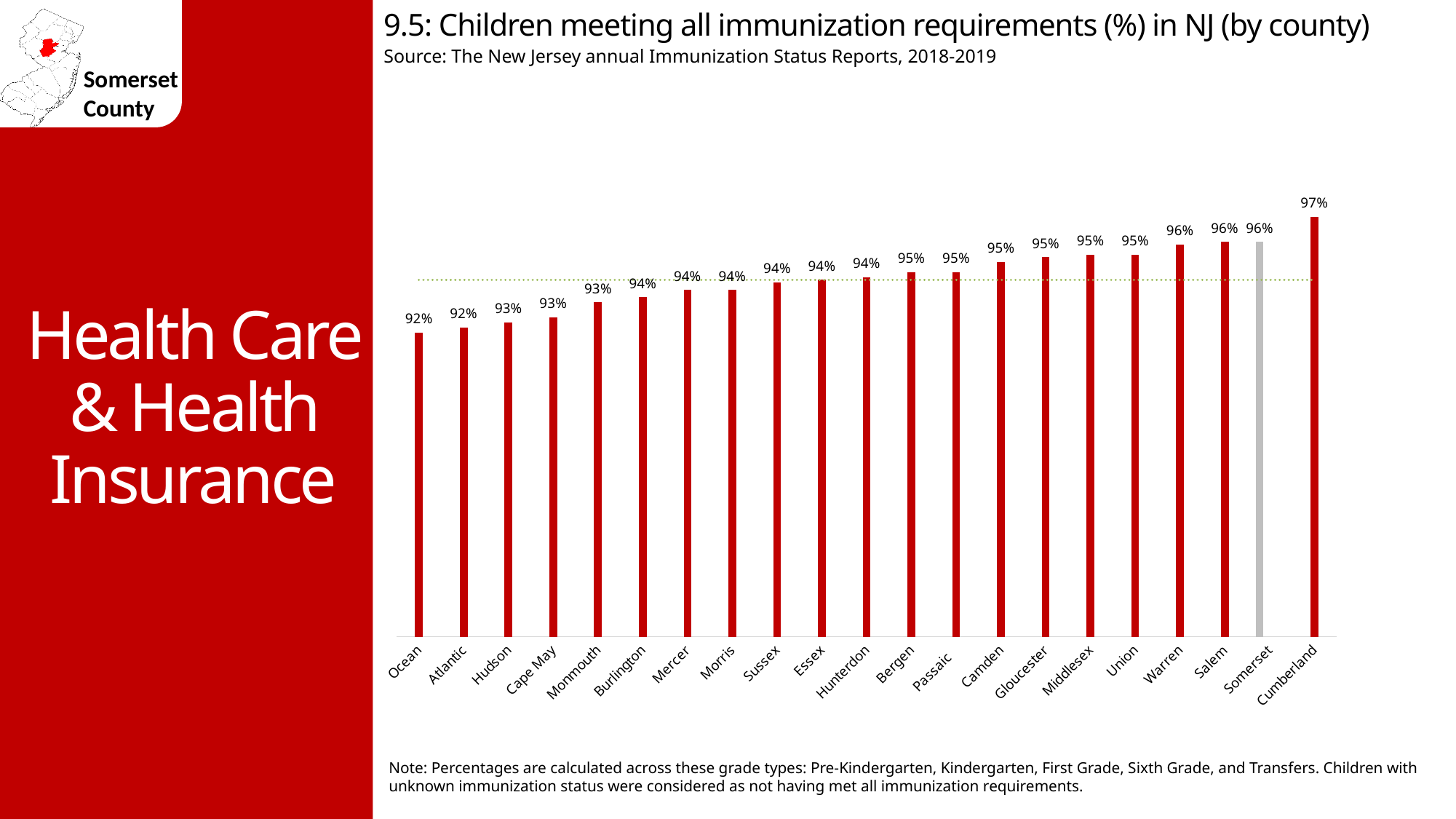
Which has a higher value, Monmouth or Warren? Warren Which has a higher value, Cumberland or Somerset? Cumberland What is the value shown for Hunterdon County? 94% What is the value shown for Middlesex County? 95% Which county has the highest percentage of children meeting all immunization requirements? Cumberland What is the value shown for Ocean County? 92% What percentage of children in Somerset County met all immunization requirements? 96% What is the difference in percentage points between Somerset and Hudson counties? 3 percentage points How many counties are shown in the chart? 21 What is the difference in percentage points between Cumberland and Ocean counties? 5 percentage points What kind of chart is shown on the slide? Bar chart Do the values rise or fall from left to right across the counties? Rise